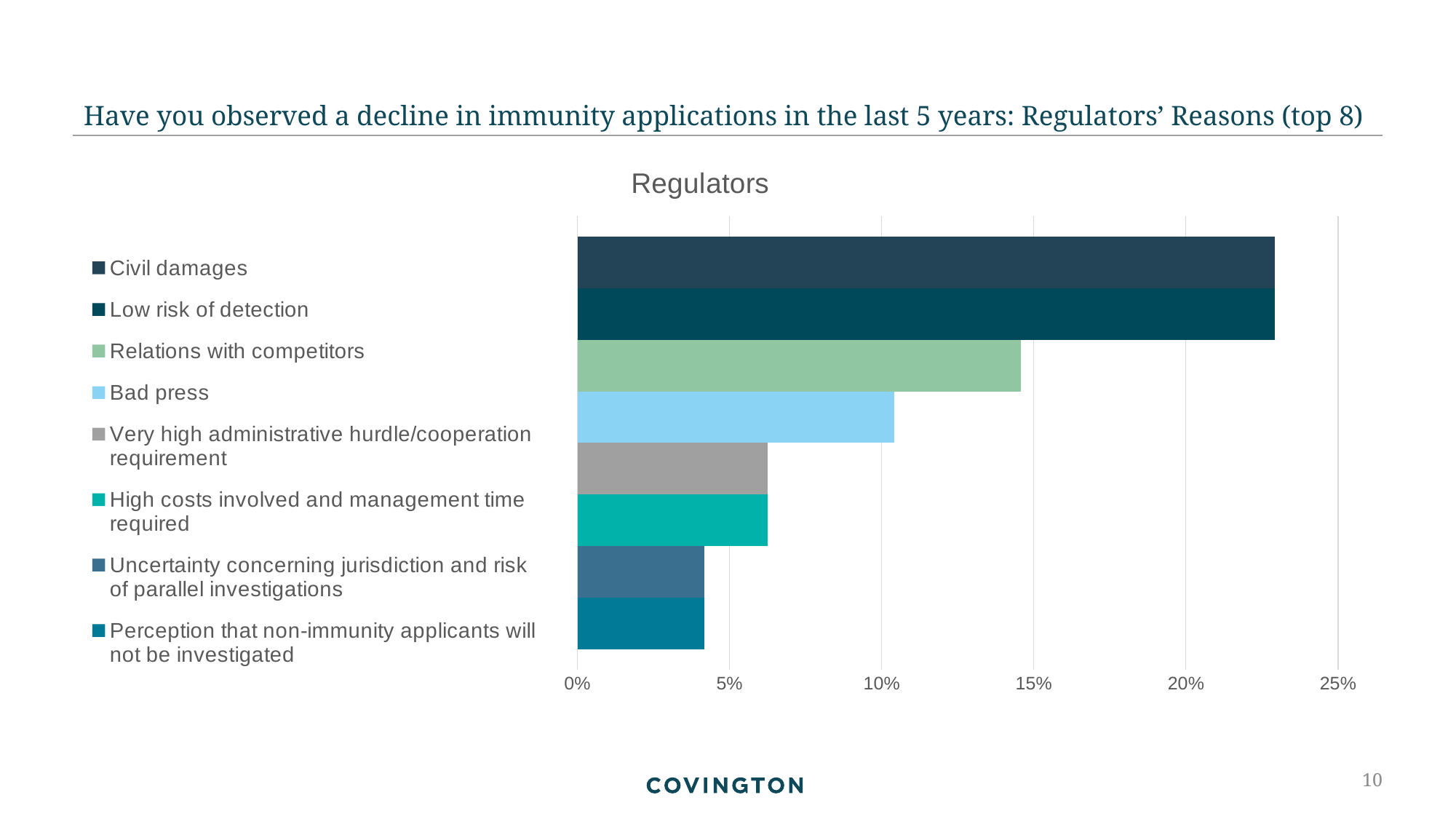
What is the title of the chart? Regulators Which is larger, the value for Relations with competitors or the value for Bad press? Relations with competitors Is the value for Civil damages greater or less than 20%? greater Is the value for Bad press greater or less than 10%? greater How many entries does the legend list? 8 Is the value for Uncertainty concerning jurisdiction and risk of parallel investigations greater or less than 5%? less What kind of chart is shown on the slide? Bar chart How many categories (bars) does the chart show? 8 Which is larger, the value for Low risk of detection or the value for High costs involved and management time required? Low risk of detection What colour is the bar for Bad press? Light blue